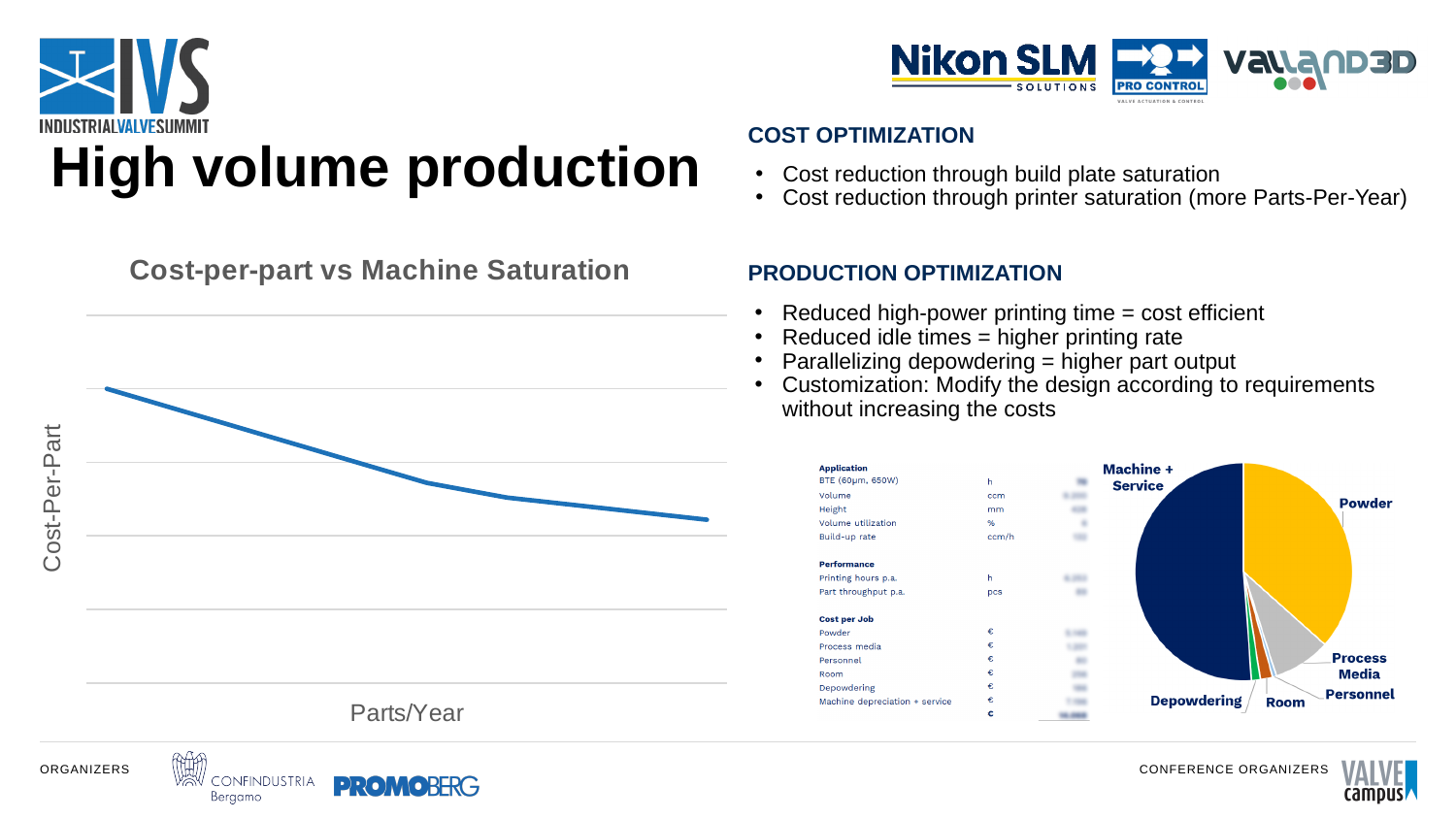
What kind of chart is the 'Cost-per-part vs Machine Saturation' chart? line chart What is the y-axis label of the 'Cost-per-part vs Machine Saturation' chart? Cost-Per-Part In the pie chart on the lower right of the slide, which slice is larger: Powder or Process Media? Powder In the 'Cost-per-part vs Machine Saturation' chart, does the line rise or fall as Parts/Year increases? fall What kind of chart is the chart on the lower right of the slide showing cost categories? pie chart In the pie chart on the lower right of the slide, which slice is larger: Machine + Service or Powder? Machine + Service Which category has the largest slice in the pie chart on the lower right of the slide? Machine + Service What is the x-axis label of the 'Cost-per-part vs Machine Saturation' chart? Parts/Year How many slices does the pie chart on the lower right of the slide have? 6 In the pie chart on the lower right of the slide, which slice is larger: Process Media or Room? Process Media